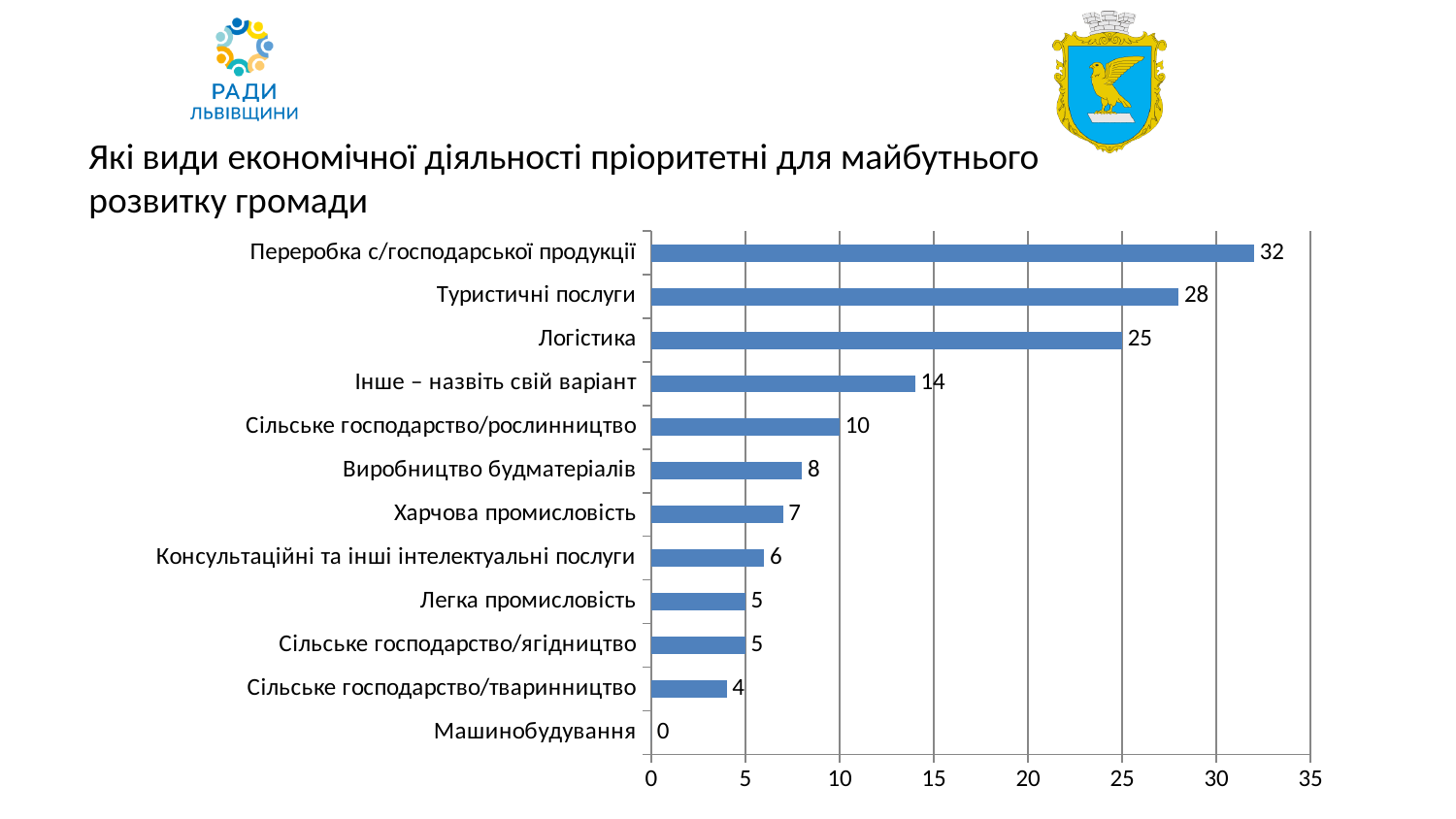
Which category has the lowest value? Машинобудування Which is larger, the value for Виробництво будматеріалів or the value for Сільське господарство/рослинництво? Сільське господарство/рослинництво What kind of chart is shown on the slide? bar chart Which category has the highest value? Переробка с/господарської продукції What is the difference between the values for Туристичні послуги and Логістика? 3 What is the maximum value shown on the horizontal axis? 35 What is the difference between the values for Переробка с/господарської продукції and Інше – назвіть свій варіант? 18 What is the value for Харчова промисловість? 7 How many categories are shown in the chart? 12 What is the value for Переробка с/господарської продукції? 32 What is the value for Машинобудування? 0 What is the value for Логістика? 25